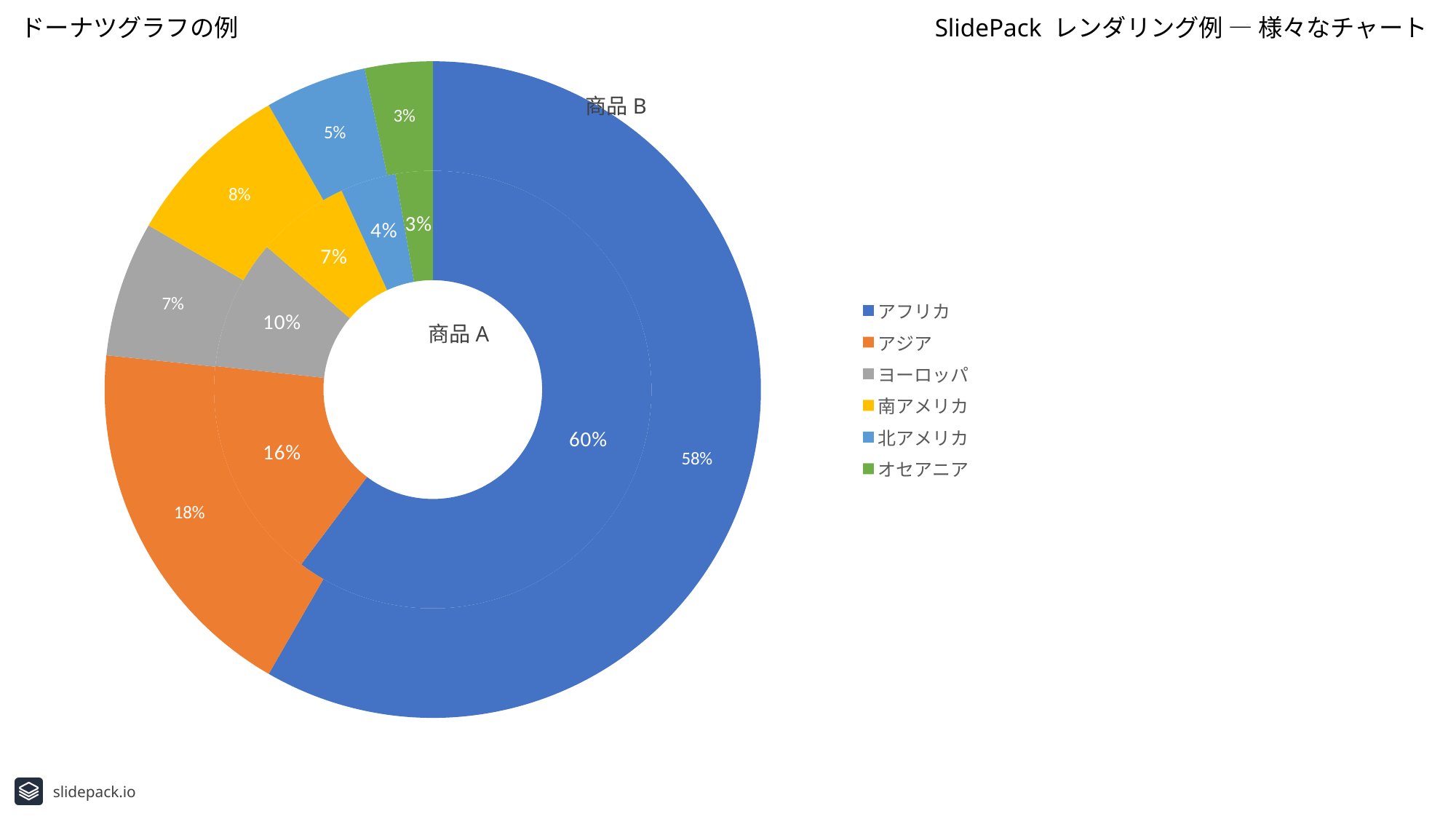
Which category has the smallest share in the 商品 A ring? オセアニア Which category has the largest share in the 商品 B ring? アフリカ What is the difference between the アジア share in 商品 B and in 商品 A? 2% What is the share of アフリカ in the 商品 A ring? 60% What is the share of 北アメリカ in the 商品 A ring? 4% What is the share of アジア in the 商品 B ring? 18% What is the share of アフリカ in the 商品 B ring? 58% How many categories does the legend list? 6 What is the share of ヨーロッパ in the 商品 A ring? 10% What kind of chart is shown on the slide? Doughnut chart What is the title of the chart? ドーナツグラフの例 Which is larger: the 南アメリカ share in 商品 A or in 商品 B? 商品 B